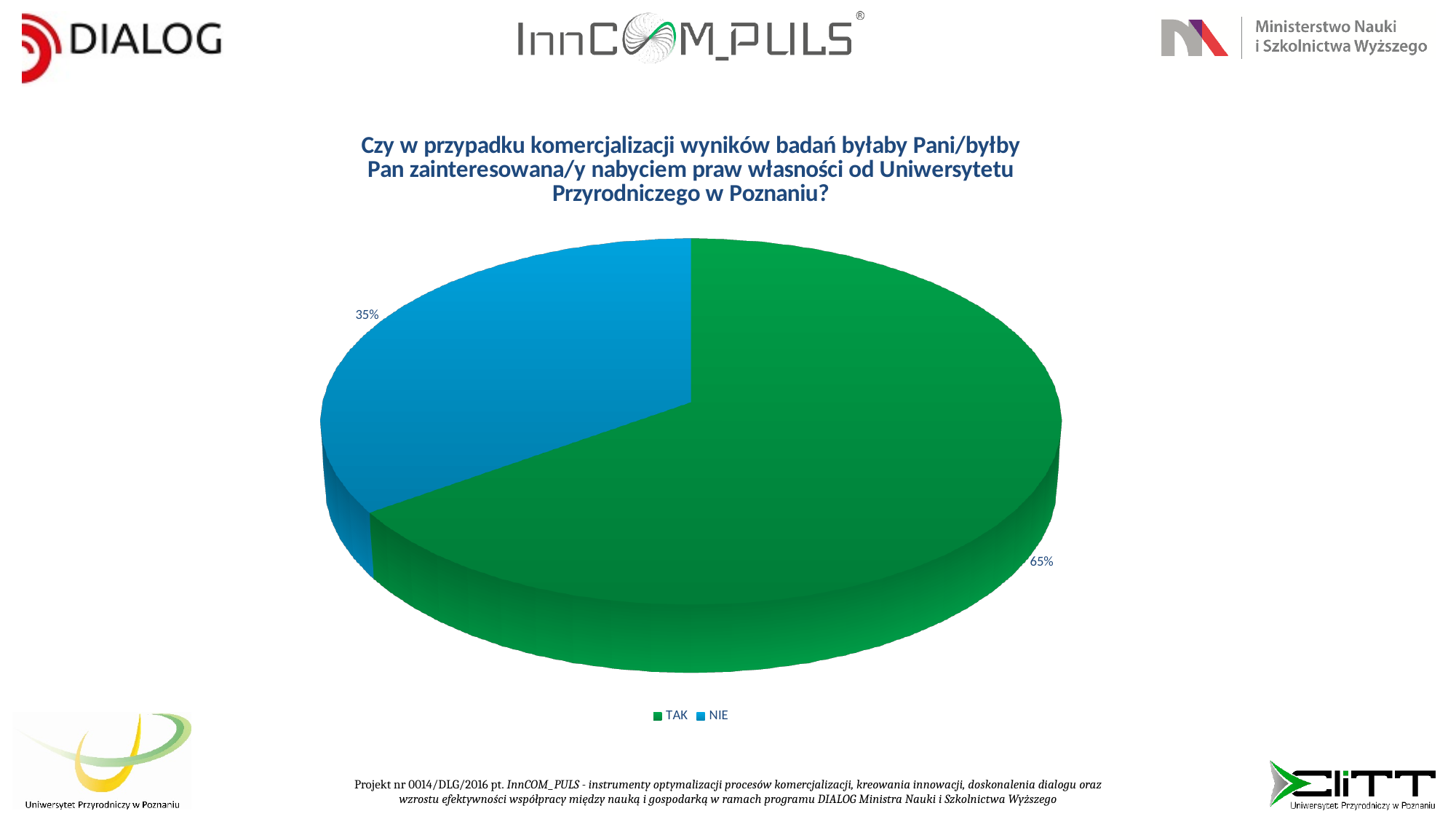
Which slice is larger, TAK or NIE? TAK What is the difference in percentage points between the TAK and NIE slices? 30 What kind of chart is shown on the slide? Pie chart What share of the pie does TAK represent? 65% Which category has the largest slice of the pie? TAK What share of the pie does NIE represent? 35% What colour is the TAK slice? Green Which category has the smallest slice of the pie? NIE What colour is the NIE slice? Blue How many categories does the pie chart show? 2 How many entries does the legend list? 2